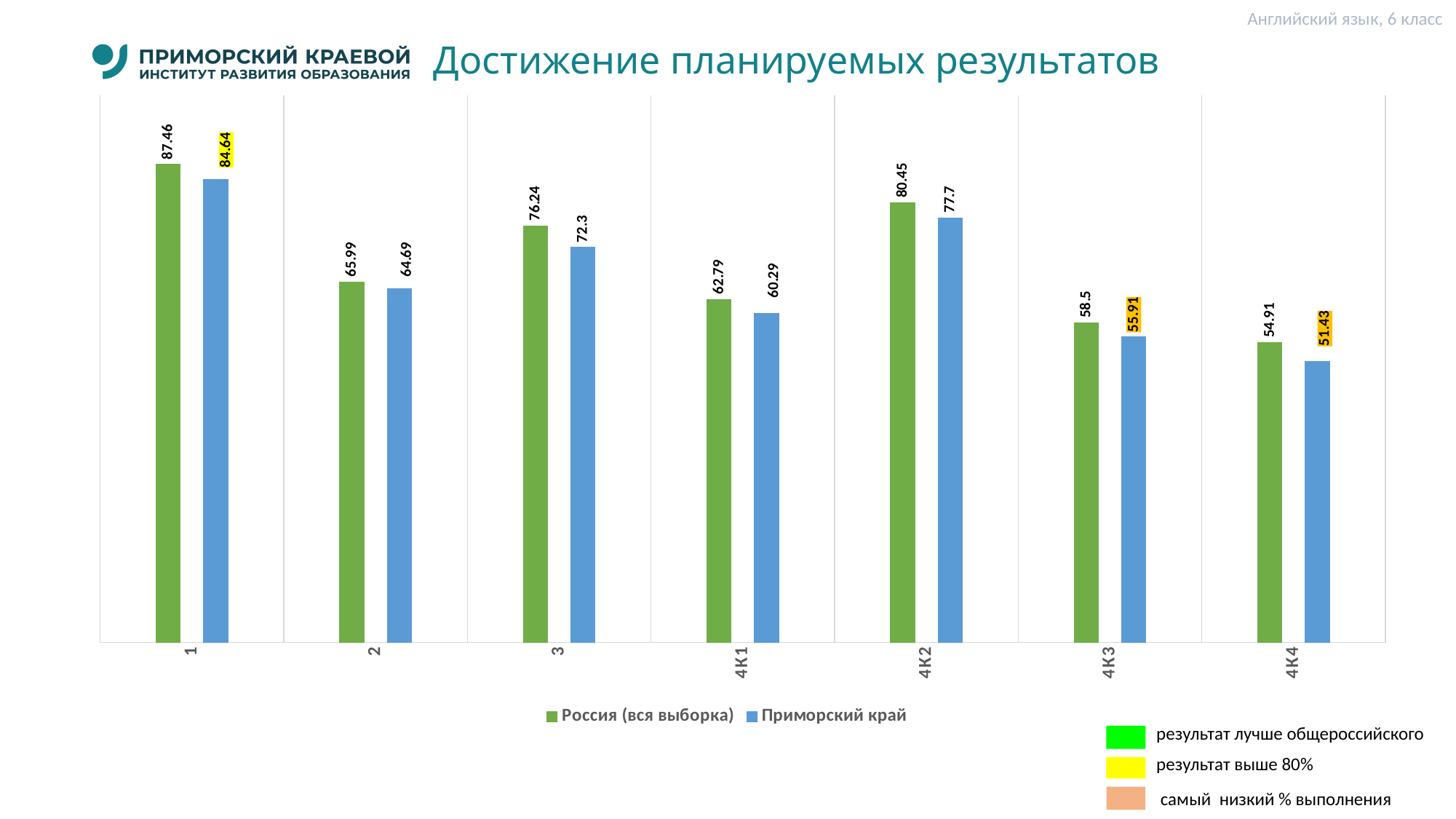
Which category has the highest value for Россия (вся выборка)? 1 What is the title of the chart on the slide? Достижение планируемых результатов Which is larger in category 4К1: Россия (вся выборка) or Приморский край? Россия (вся выборка) Which category has the lowest value for Приморский край? 4К4 What is the difference between Россия (вся выборка) and Приморский край in category 3? 3.94 What is the difference between Россия (вся выборка) and Приморский край in category 4К3? 2.59 What kind of chart is shown on the slide? Bar chart How many series does the legend list? 2 What is the value for Приморский край in category 4К4? 51.43 What is the value for Россия (вся выборка) in category 4К2? 80.45 What is the value for Приморский край in category 1? 84.64 How many categories are shown on the x axis? 7